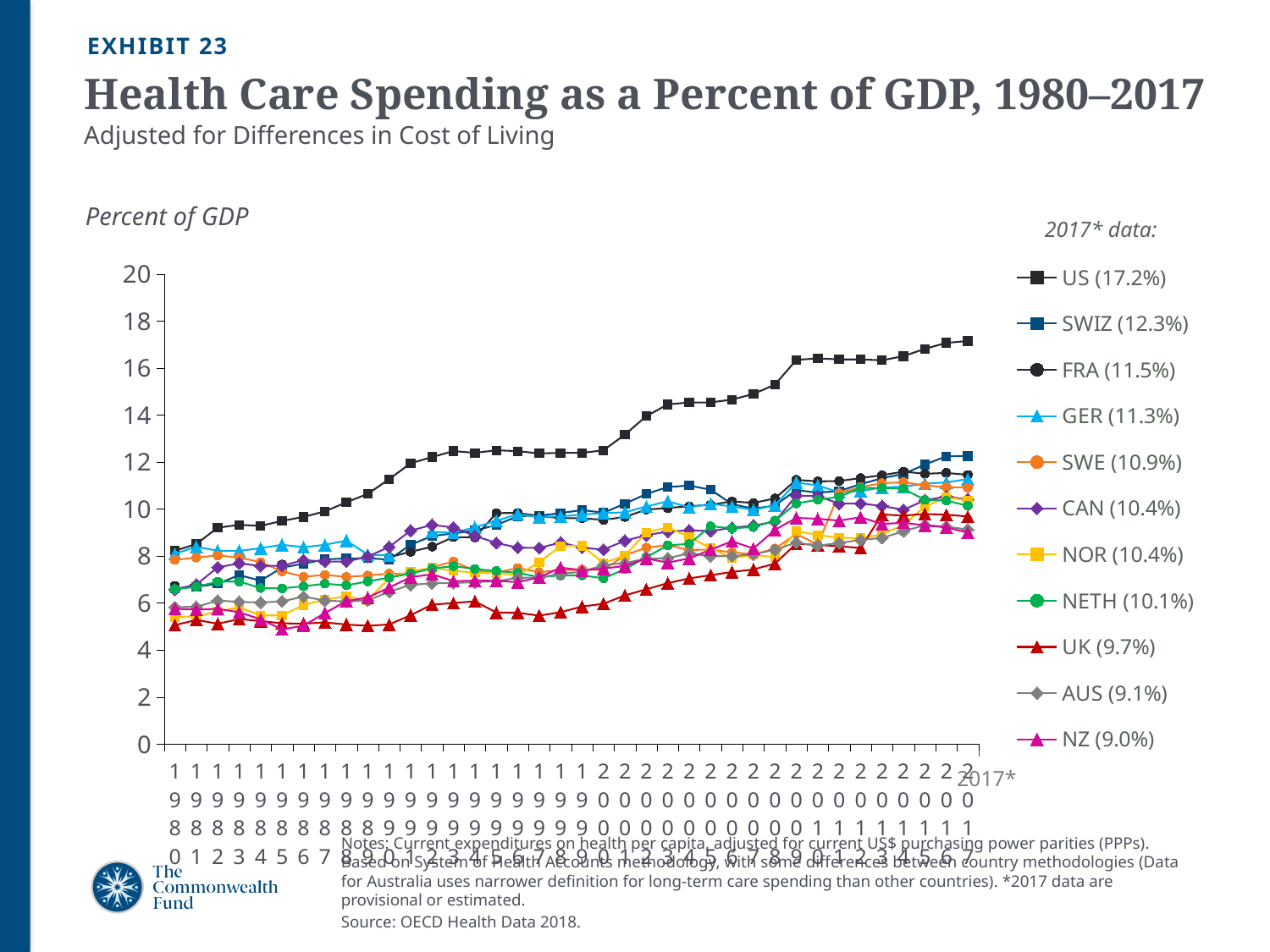
Does the US line rise or fall from 1980 to 2017? Rise What was US health care spending as a percent of GDP in 2017 according to the legend? 17.2% What is the title of the chart? Health Care Spending as a Percent of GDP, 1980–2017 What is the 2017 value shown for the UK? 9.7% Is the value for the US in 2010 greater or less than 14? greater What is the difference between the 2017 values for the US and SWIZ? 4.9 percentage points What kind of chart is shown on the slide? Line chart How many countries (series) does the legend list? 11 Which country has the lowest 2017 value in the legend? NZ Which has the larger 2017 value, FRA or GER? FRA Which country has the highest health care spending as a percent of GDP in 2017? US Is the value for the US in 1980 greater or less than 10? less